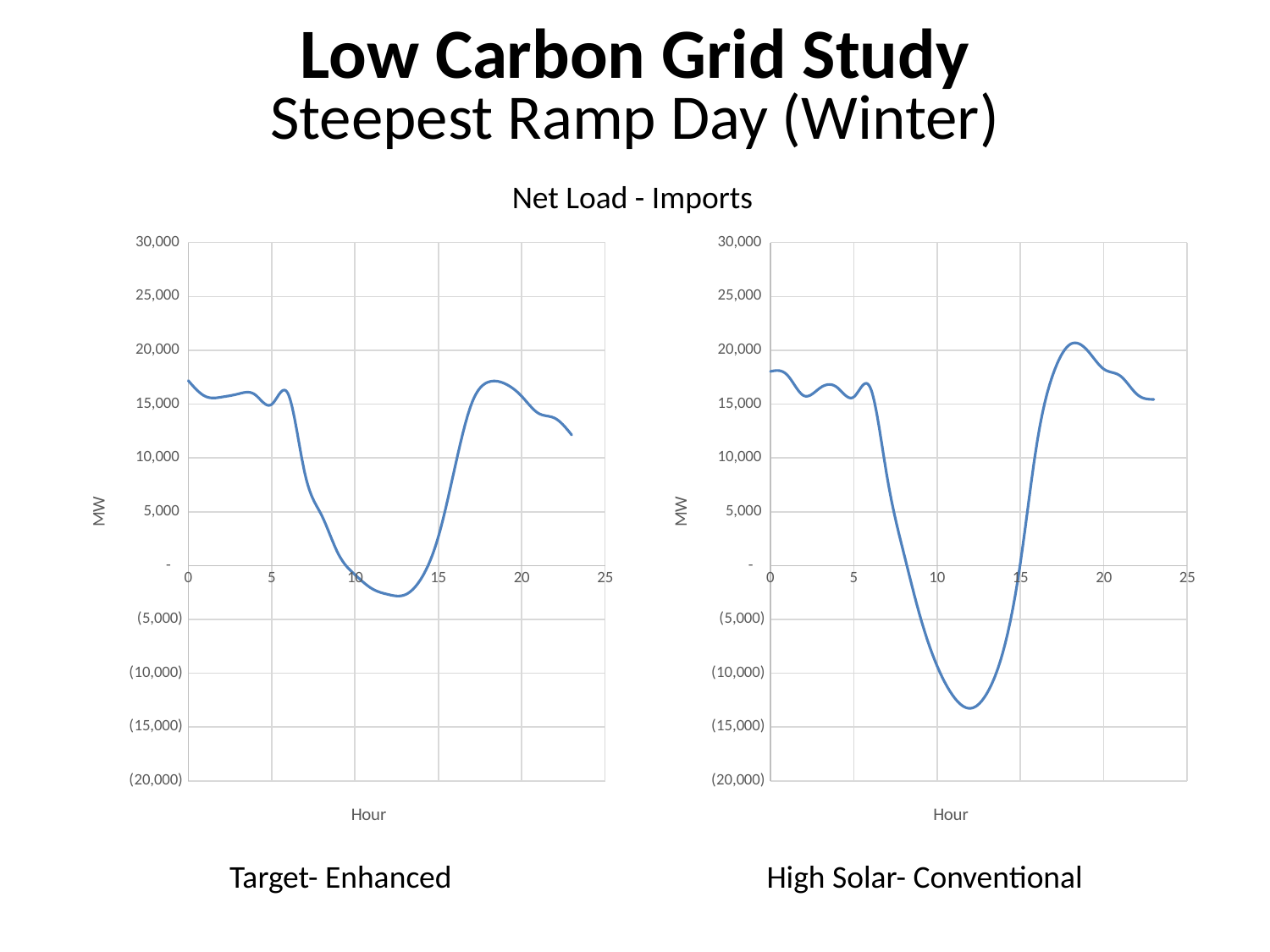
Which chart reaches a lower minimum value, Target- Enhanced or High Solar- Conventional? High Solar- Conventional In the High Solar- Conventional chart, is the value at hour 0 greater or less than 15,000? greater In the High Solar- Conventional chart, is the value at hour 18 greater or less than 15,000? greater In the Target- Enhanced chart, is the value at hour 12 greater or less than 0? less What is the shared title above the two charts? Net Load - Imports What kind of chart is the Target- Enhanced chart on the left? line chart In the Target- Enhanced chart, do the values rise or fall between hour 6 and hour 12? fall In the High Solar- Conventional chart, do the values rise or fall between hour 12 and hour 18? rise What kind of chart is the High Solar- Conventional chart on the right? line chart What is the label on the y axis of both charts? MW